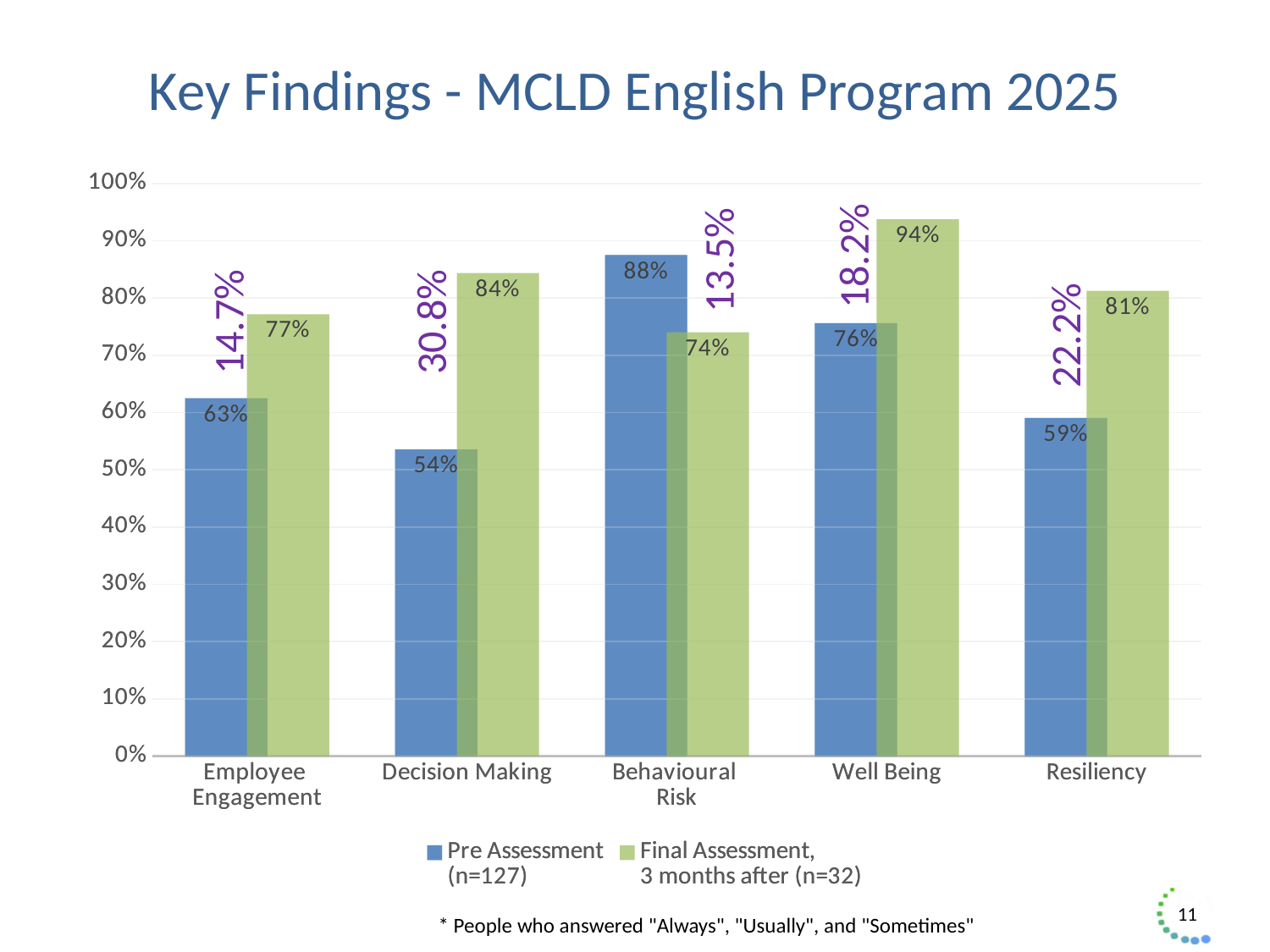
Which category has the lowest Pre Assessment value? Decision Making What kind of chart is shown on the slide? Bar chart Which category has the highest Final Assessment value? Well Being What is the Pre Assessment value for Decision Making? 54% What is the Final Assessment value for Well Being? 94% For Behavioural Risk, which is larger: the Pre Assessment value or the Final Assessment value? Pre Assessment What is the purple percentage annotation shown above the Well Being bars? 18.2% How many series does the legend list? 2 What is the Pre Assessment value for Behavioural Risk? 88% Is the Final Assessment value for Resiliency greater or less than 80%? greater How many categories are shown on the x axis? 5 What is the difference between the Final Assessment and Pre Assessment values for Decision Making? 30%